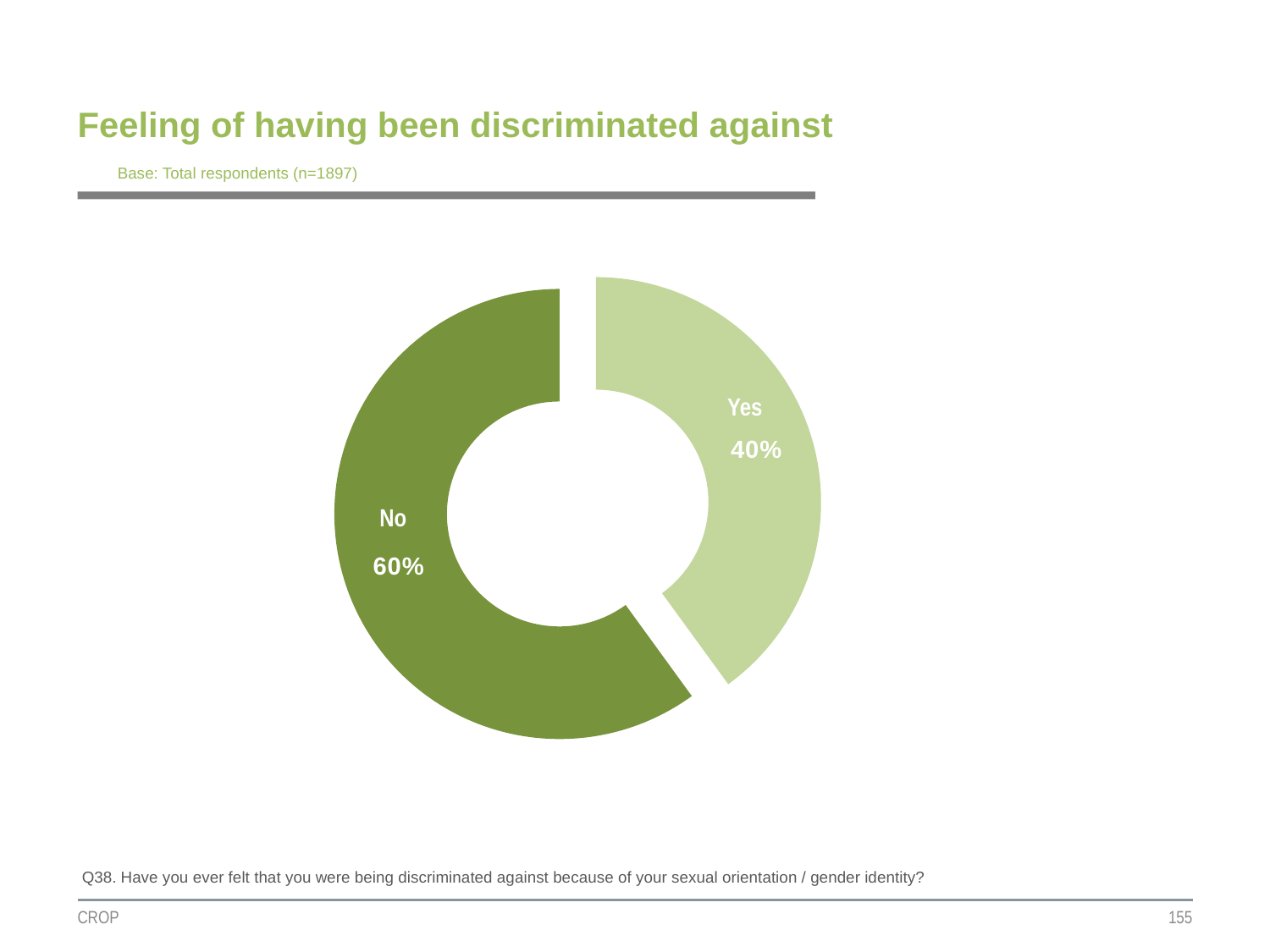
What percentage of respondents answered Yes? 40% Which response has the largest share of the chart? No Which is larger, the share for Yes or the share for No? No How many total respondents form the base for the chart? 1897 Is the value for Yes greater or less than 50%? less What percentage of respondents answered No? 60% What share of the chart does the Yes slice represent? 40% How many categories are shown in the chart? 2 What kind of chart is shown on the slide? Doughnut chart Which response has the smallest share of the chart? Yes What is the title of the chart on the slide? Feeling of having been discriminated against What is the difference in percentage points between the No and Yes responses? 20